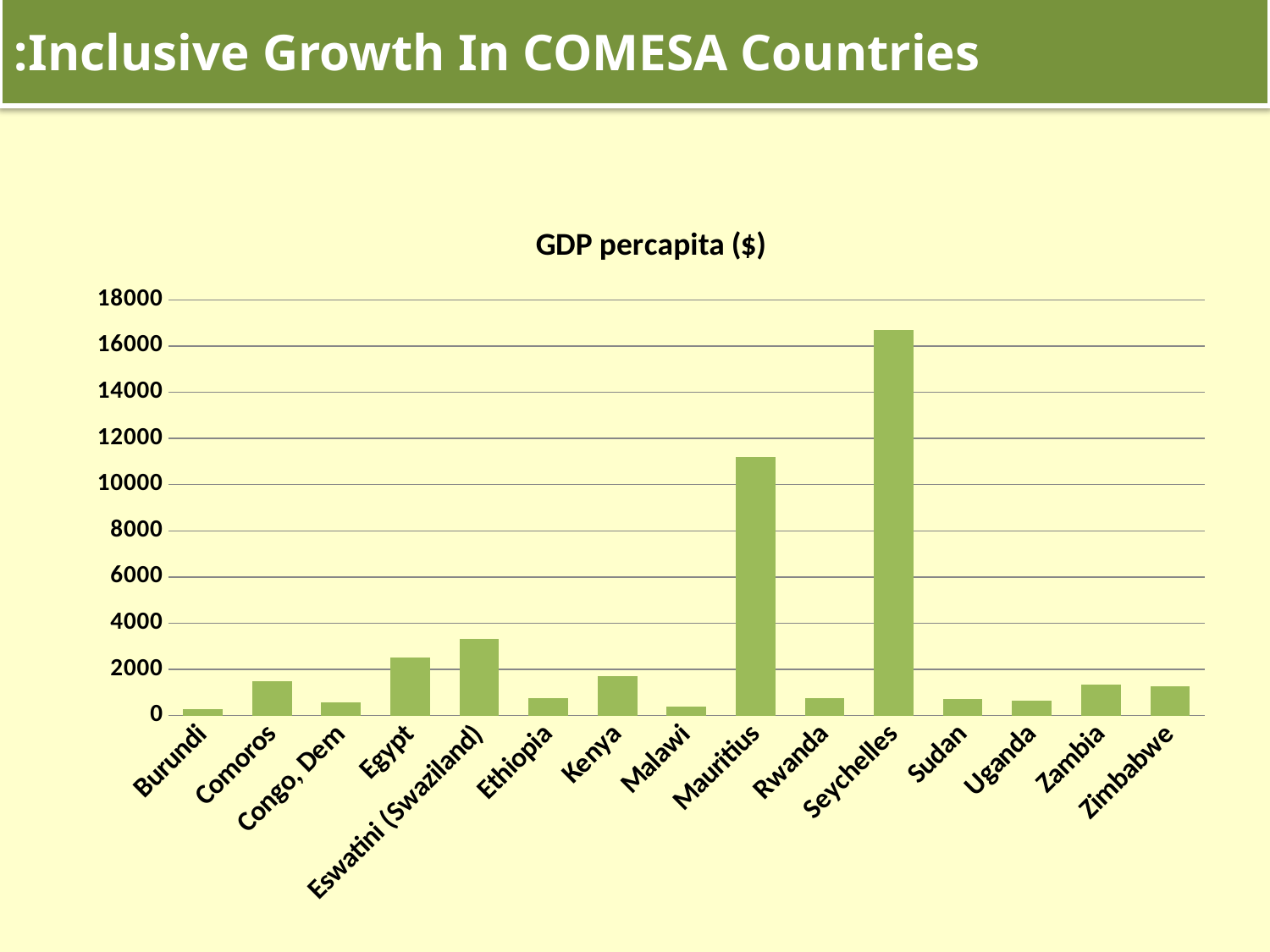
Which country has the highest GDP per capita in the chart? Seychelles Is the value for Mauritius greater or less than 10000? greater How many countries are shown on the x axis of the chart? 15 Is the value for Egypt greater or less than 2000? greater Which has a higher GDP per capita, Mauritius or Seychelles? Seychelles Is the value for Eswatini (Swaziland) greater or less than 4000? less Which country has the lowest GDP per capita in the chart? Burundi What kind of chart is shown on the slide? bar chart What is the title of the chart? GDP percapita ($) Which has a higher GDP per capita, Egypt or Eswatini (Swaziland)? Eswatini (Swaziland)